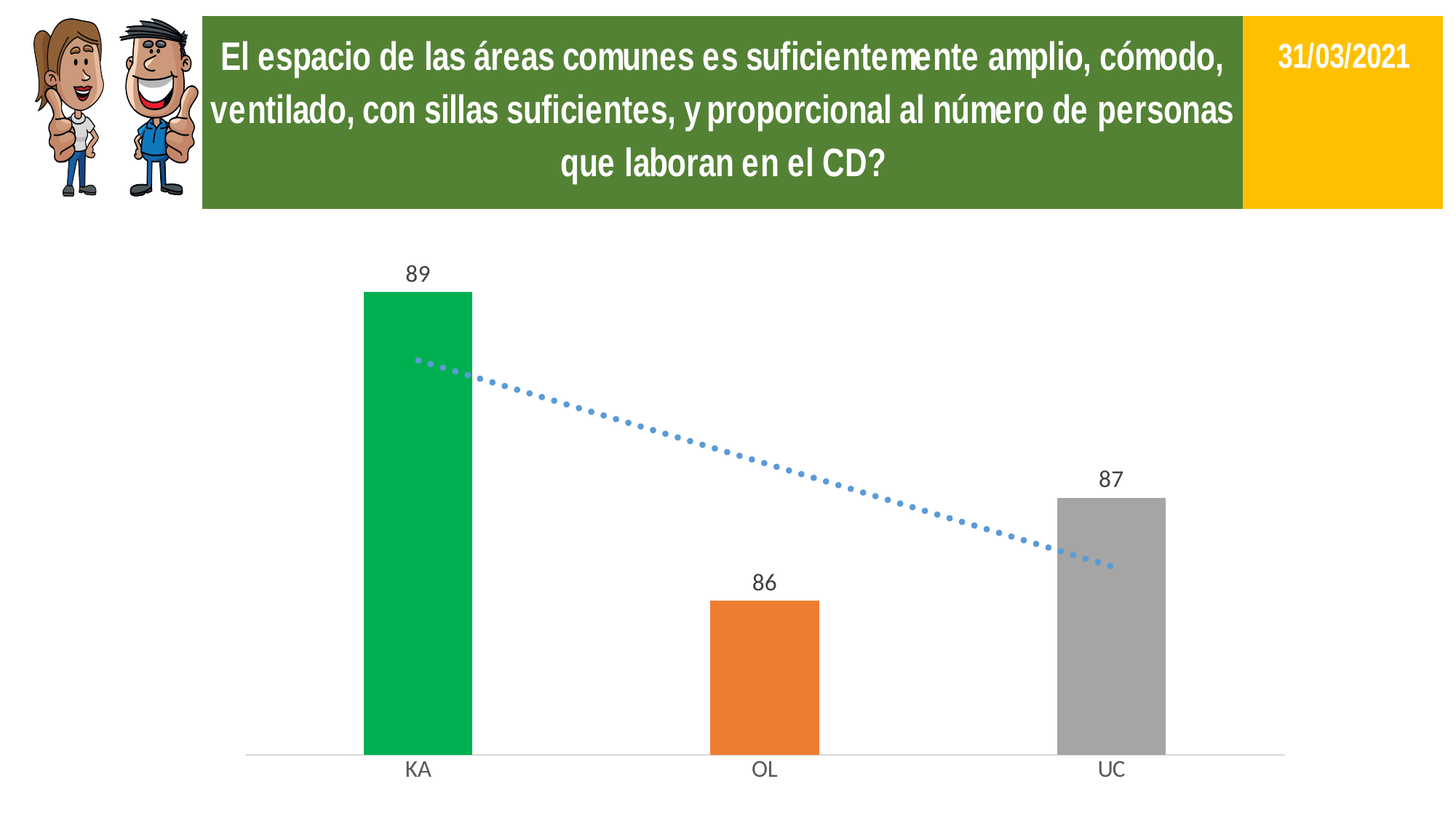
Which category has the highest value? KA What is the value for OL? 86 What date is shown in the yellow box at the top right of the slide? 31/03/2021 What is the difference between the values for UC and OL? 1 What is the difference between the values for KA and OL? 3 Which is larger, the value for KA or the value for UC? KA What colour is the bar for OL? orange Which category has the lowest value? OL How many categories are shown on the x axis? 3 What kind of chart is shown on the slide? bar chart What is the value for KA? 89 What is the value for UC? 87